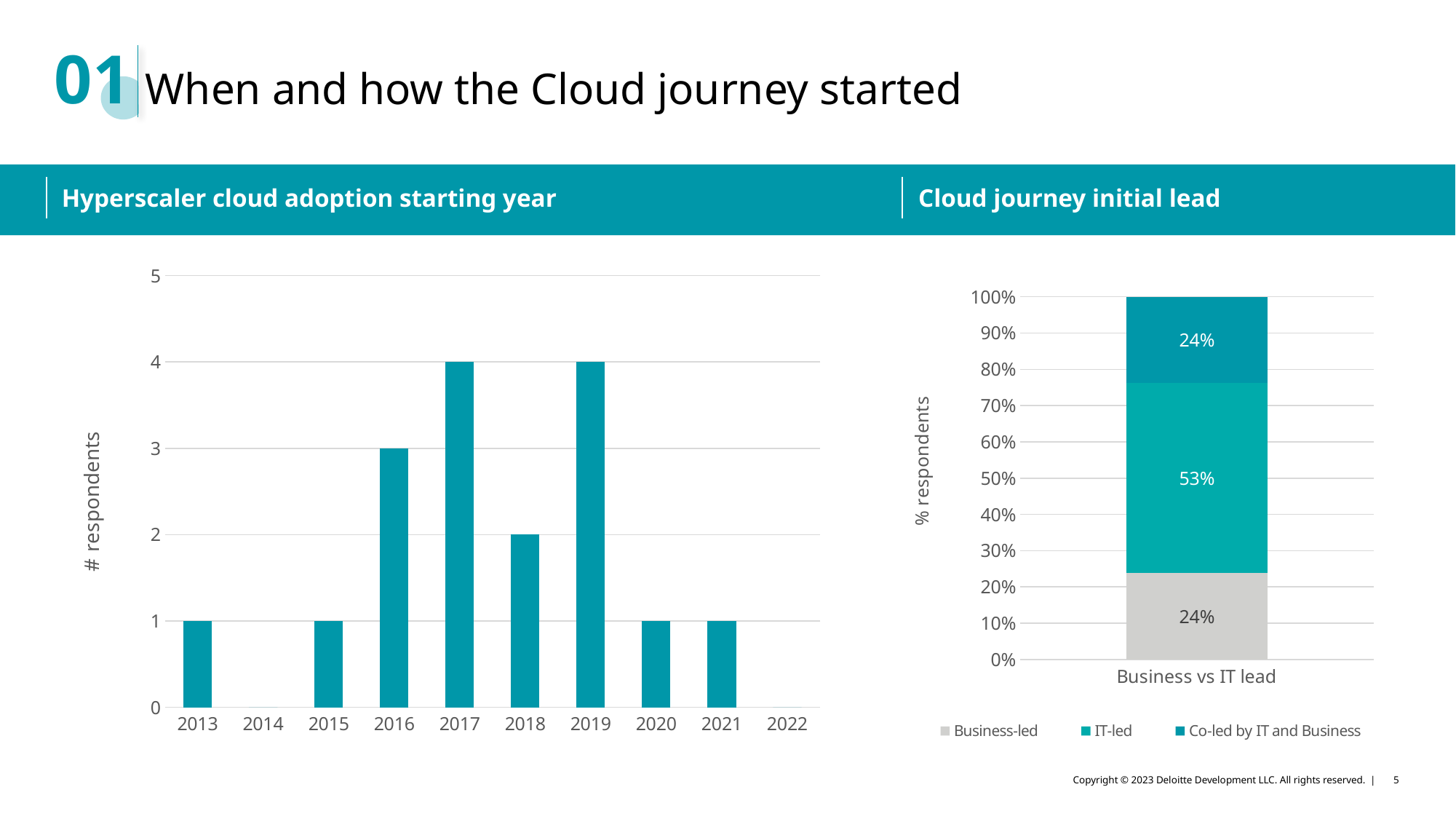
In the 'Hyperscaler cloud adoption starting year' chart, which year has more respondents, 2016 or 2020? 2016 How many years are shown on the x axis of the 'Hyperscaler cloud adoption starting year' chart? 10 In the 'Cloud journey initial lead' chart, what percentage of respondents were IT-led? 53% In the 'Hyperscaler cloud adoption starting year' chart, how many respondents started in 2018? 2 In the 'Hyperscaler cloud adoption starting year' chart, how many respondents started in 2017? 4 In the 'Cloud journey initial lead' chart, what percentage of respondents were Business-led? 24% In the 'Cloud journey initial lead' chart, what is the difference between the IT-led share and the Co-led by IT and Business share? 29% In the 'Hyperscaler cloud adoption starting year' chart, how many respondents started in 2016? 3 How many series does the legend of the 'Cloud journey initial lead' chart list? 3 In the 'Hyperscaler cloud adoption starting year' chart, what is the difference in respondents between 2019 and 2018? 2 What type of chart is the 'Hyperscaler cloud adoption starting year' chart? Bar chart In the 'Hyperscaler cloud adoption starting year' chart, how many respondents started in 2014? 0